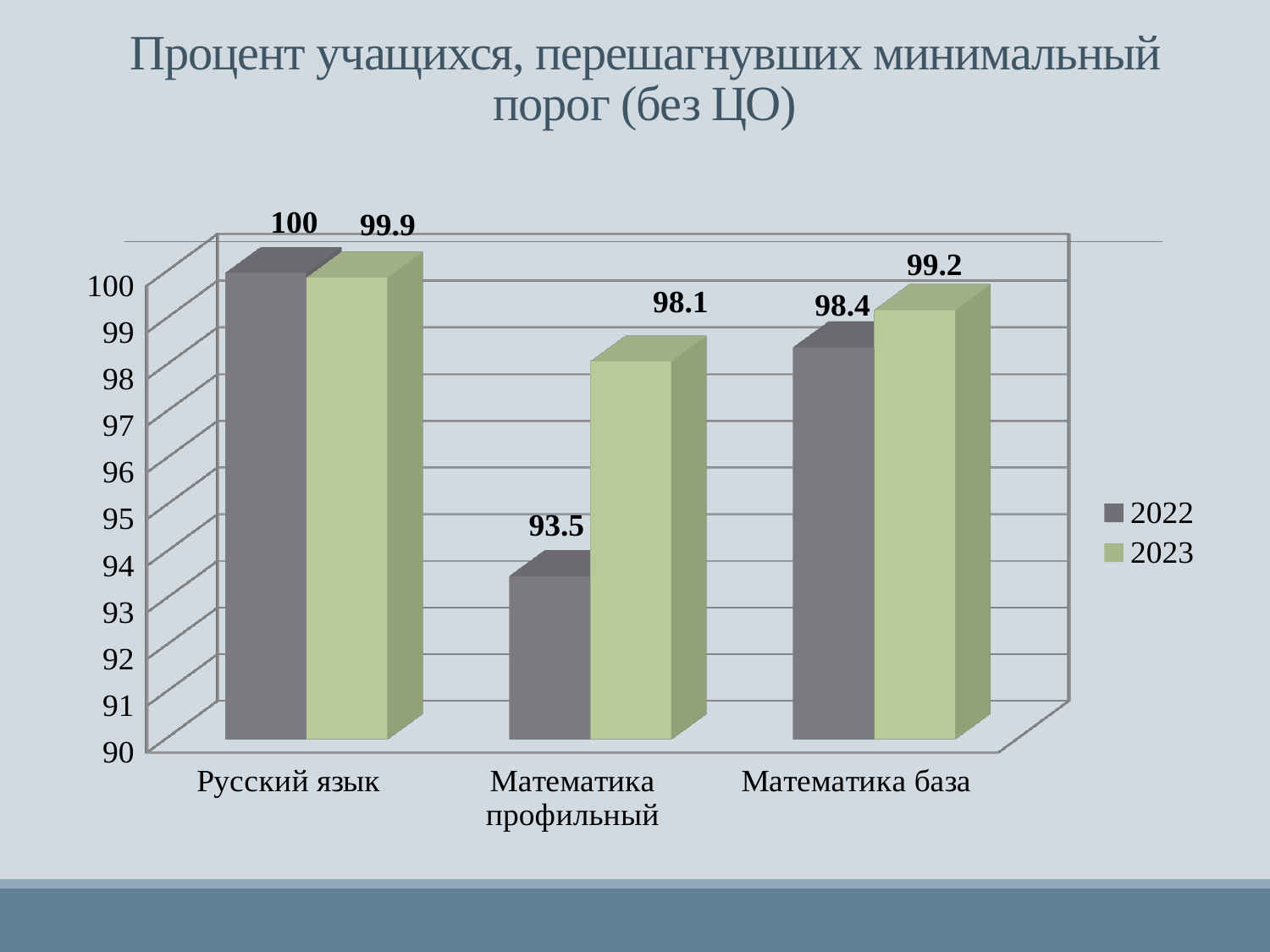
How many series does the legend list? 2 What is the value for Русский язык in 2022? 100 How many categories are shown on the x axis? 3 What is the difference between the 2022 and 2023 values for Русский язык? 0.1 Which is larger for Математика база: the 2022 value or the 2023 value? 2023 What kind of chart is shown on the slide? bar chart Which category has the lowest value in the 2022 series? Математика профильный What is the value for Математика профильный in 2023? 98.1 Which category has the highest value in the 2023 series? Русский язык What is the difference between the 2023 and 2022 values for Математика профильный? 4.6 What is the value for Математика база in 2022? 98.4 What is the title of the chart? Процент учащихся, перешагнувших минимальный порог (без ЦО)